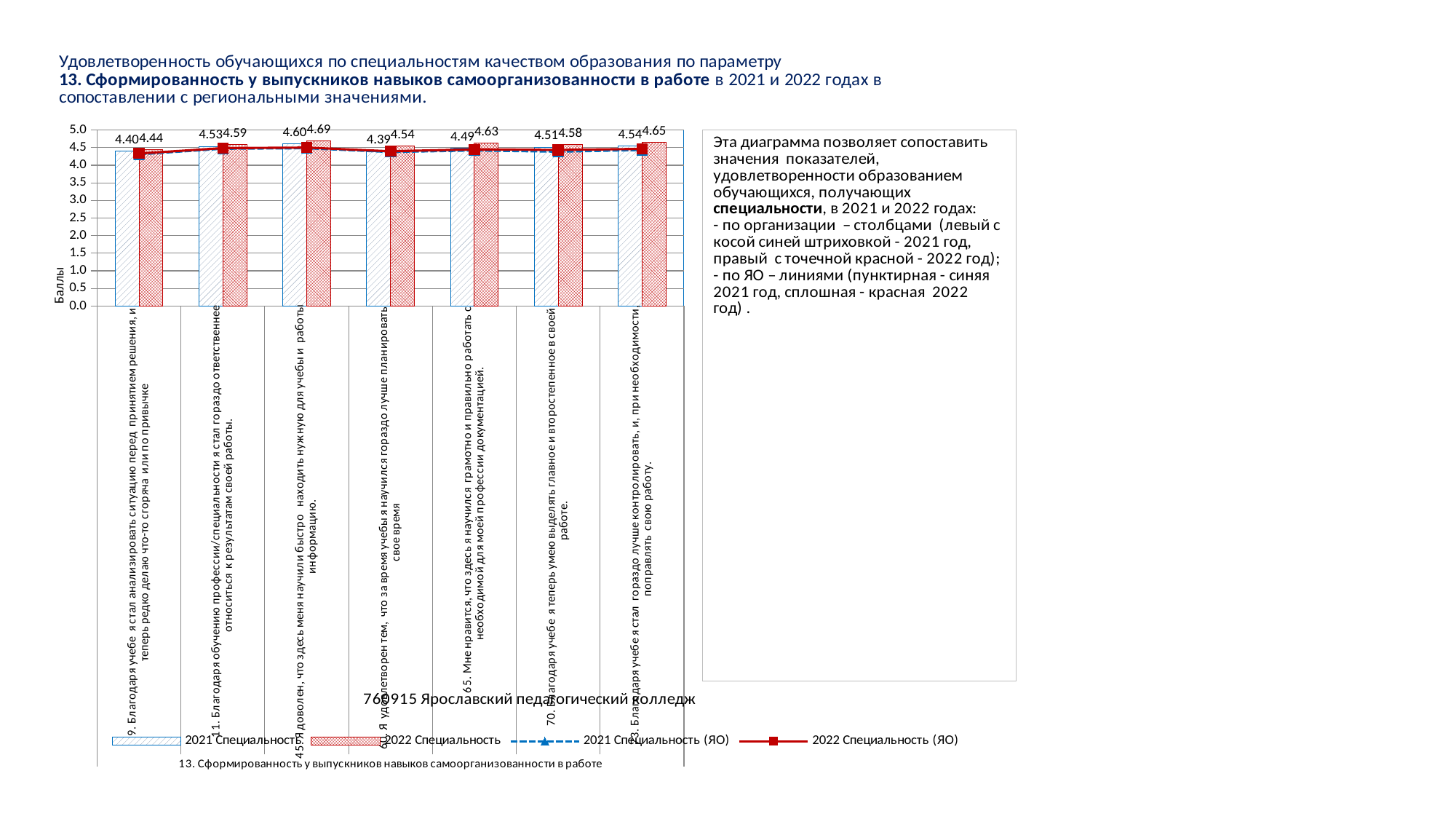
What is the value of the 2021 Специальность bar for statement 70 ("Благодаря учебе я теперь умею выделять главное и второстепенное в своей работе")? 4.51 What is the value of the 2021 Специальность bar for statement 9 ("Благодаря учебе я стал анализировать ситуацию перед принятием решения...")? 4.40 What is the label of the vertical axis of the chart? Баллы Which statement has the highest 2022 Специальность value? 45. Я доволен, что здесь меня научили быстро находить нужную для учебы и работы информацию (4.69) What kind of chart is shown on the slide? Combined bar and line chart What is the value of the 2022 Специальность bar for statement 45 ("Я доволен, что здесь меня научили быстро находить нужную для учебы и работы информацию")? 4.69 How many statements (categories) are shown on the x axis of the chart? 7 For statement 9, which is larger: the 2021 Специальность value or the 2022 Специальность value? 2022 Специальность (4.44) What is the difference between the 2022 and 2021 Специальность values for statement 11? 0.06 How many series does the chart legend list? 4 What is the value of the 2022 Специальность bar for statement 65 (about working with professional documentation)? 4.63 Which statement has the lowest 2021 Специальность value? Я удовлетворен тем, что за время учебы я научился гораздо лучше планировать свое время (4.39)